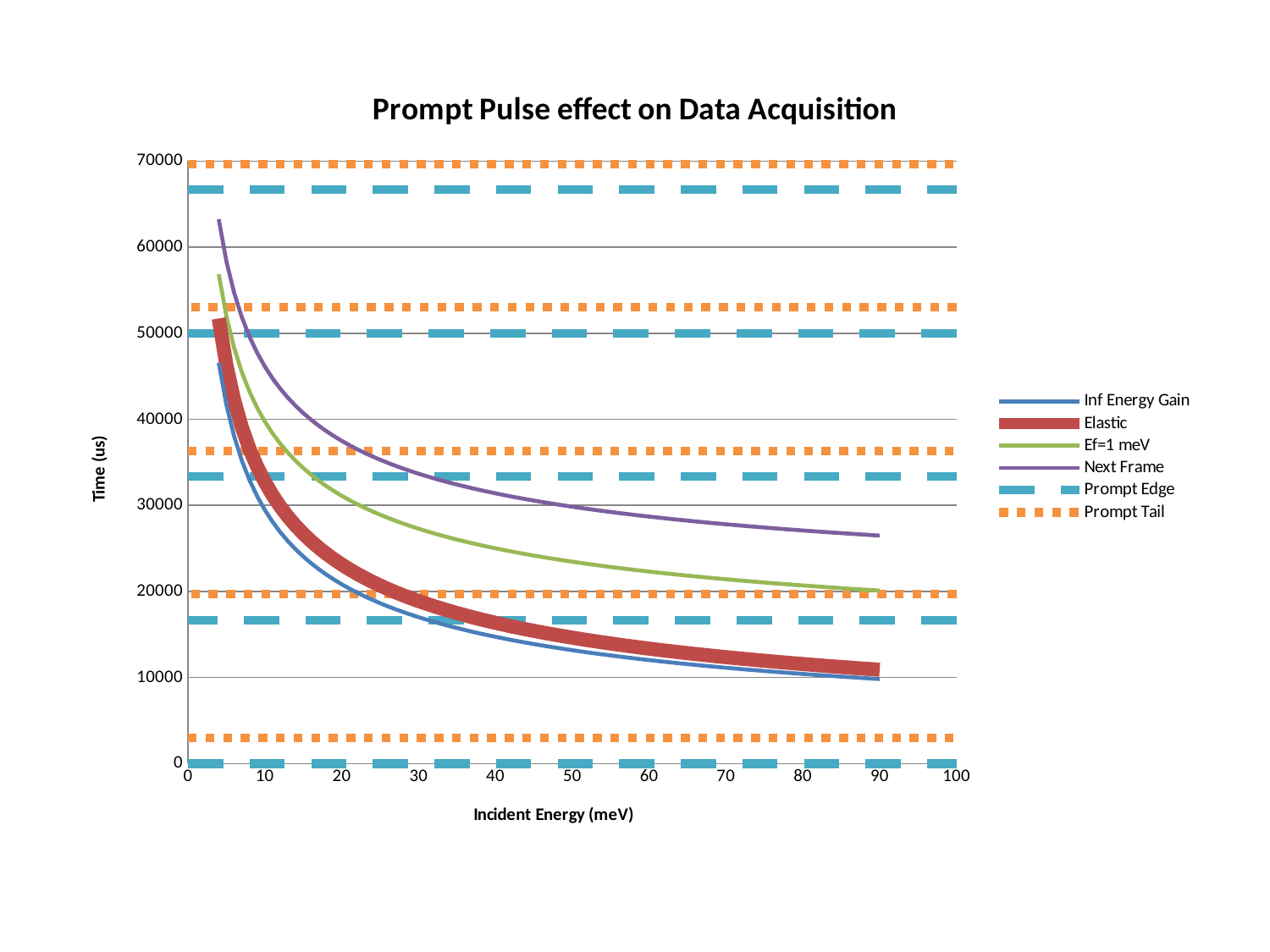
Which of the curved series has the highest value at 90 meV? Next Frame Is the value of the Inf Energy Gain series at 50 meV greater or less than 20000? less Is the value of the Next Frame series at 90 meV greater or less than 30000? less What is the title of the chart? Prompt Pulse effect on Data Acquisition What is the label of the vertical axis? Time (us) Which of the curved series has the lowest value at 90 meV? Inf Energy Gain Does the Next Frame series rise or fall as Incident Energy increases? Fall Is the value of the Ef=1 meV series at 50 meV greater or less than 20000? greater What kind of chart is shown on the slide? Line chart How many series does the legend list? 6 At 50 meV, which is larger: the Next Frame series or the Elastic series? Next Frame